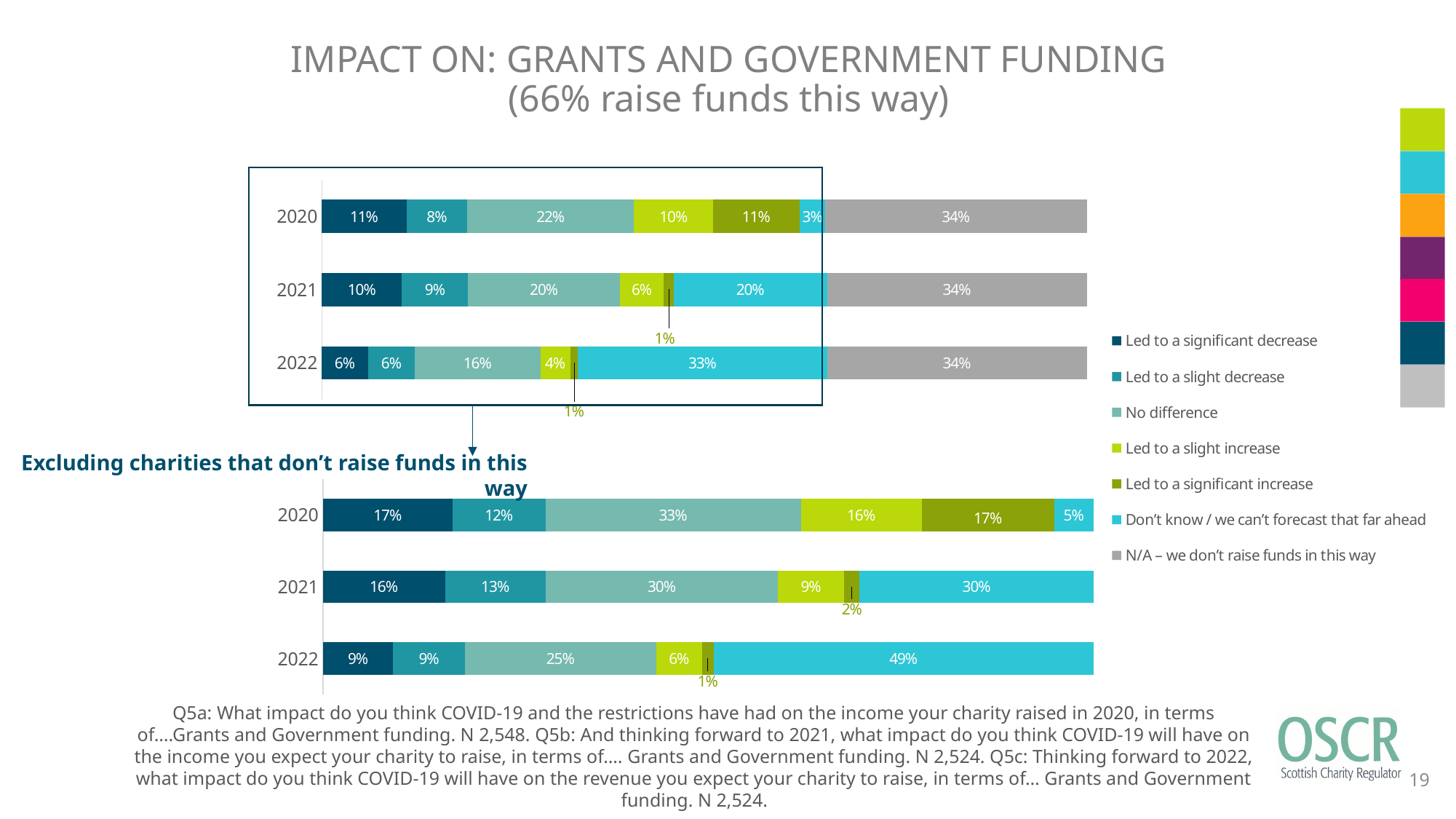
How many entries does the legend list? 7 In the bottom chart, which year has the highest 'Led to a significant decrease' value? 2020 In the bottom chart (excluding charities that don't raise funds this way), what is the 'No difference' value for 2020? 33% In the top chart, what is the difference between the 'No difference' values for 2020 and 2022? 6% How does the 'Don't know / we can't forecast that far ahead' value change from 2020 to 2022 in the bottom chart? It rises In the top chart, what is the 'Don't know / we can't forecast that far ahead' value for 2022? 33% In the top chart, what is the 'N/A – we don't raise funds in this way' value for 2021? 34% In the bottom chart, what is the 'Led to a significant increase' value for 2021? 2% In the bottom chart, is the 'Led to a slight increase' value larger for 2020 or 2022? 2020 In the bottom chart, what is the 'Don't know / we can't forecast that far ahead' value for 2022? 49% What type of chart is used on this slide? Stacked bar chart In the top chart, what percentage of charities in 2020 said grants and government funding 'Led to a significant decrease'? 11%